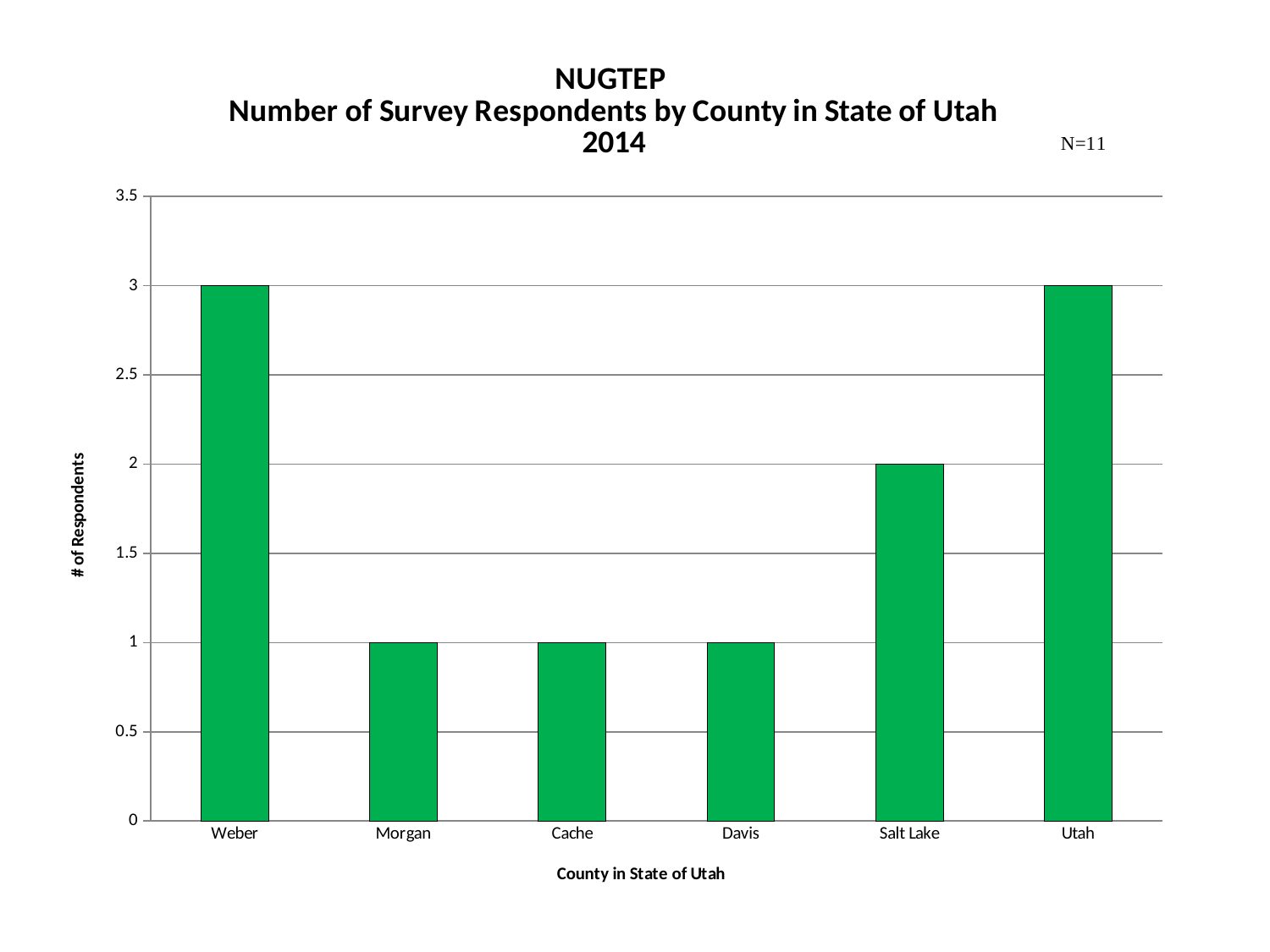
Which has more respondents, Salt Lake or Davis? Salt Lake What kind of chart is shown on the slide? bar chart What sample size (N) is noted on the slide? N=11 What is the difference in respondents between Weber and Salt Lake? 1 Is the value for Salt Lake greater or less than 1.5? greater What is the number of respondents for Weber county? 3 How many counties are shown on the x axis? 6 What is the difference in respondents between Utah and Davis? 2 Which has more respondents, Weber or Cache? Weber What is the number of respondents for Morgan county? 1 What is the number of respondents for Utah county? 3 What is the number of respondents for Salt Lake county? 2